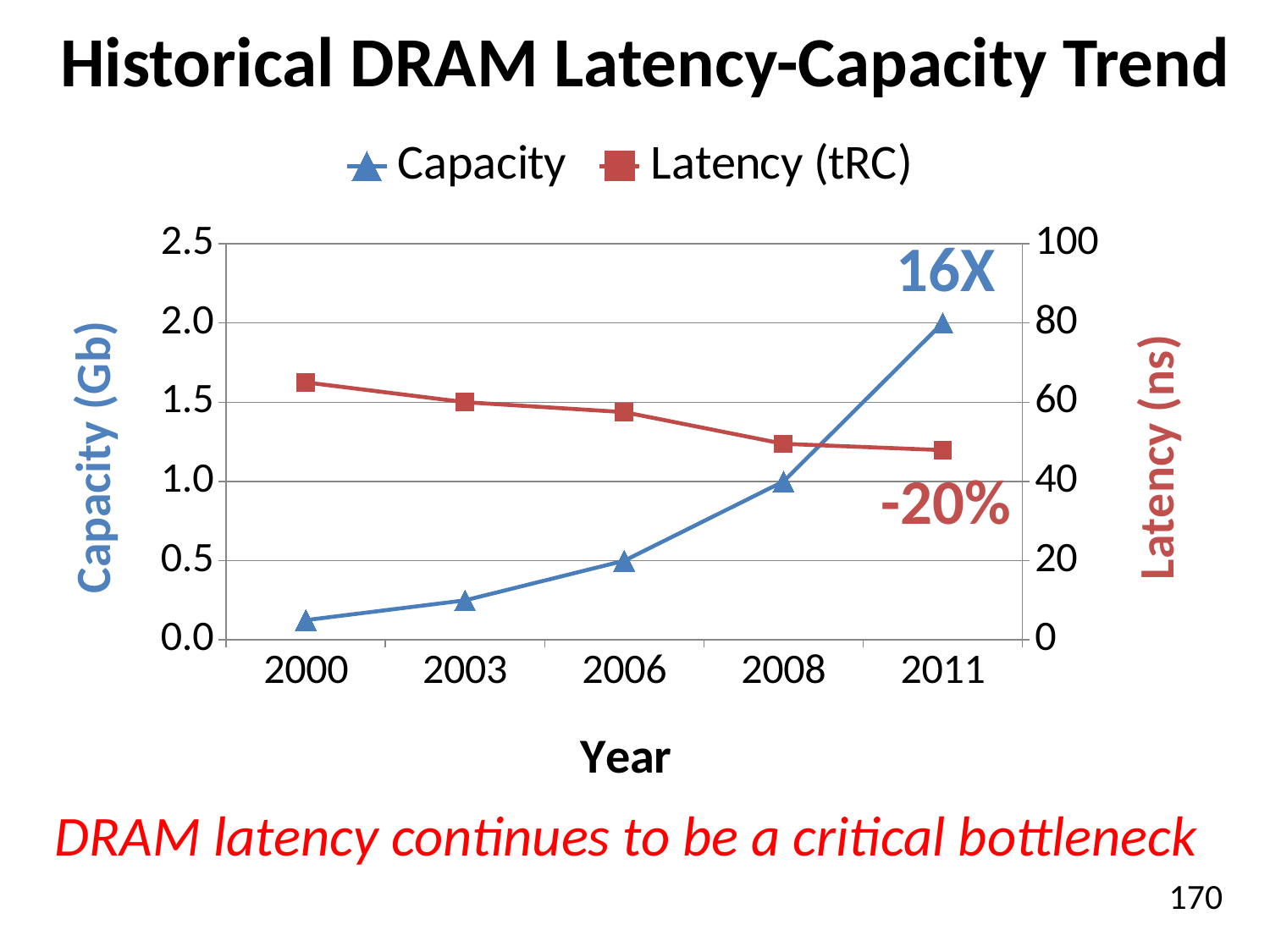
Is the Capacity value for 2006 greater or less than 1.0? less What kind of chart is shown on the slide? Line chart How many series does the legend list? 2 In which year is Latency (tRC) highest? 2000 What is the Capacity value for 2008? 1.0 Is the Latency (tRC) value for 2011 greater or less than 60? less How many years are plotted along the x axis? 5 Does Latency (tRC) rise or fall from 2000 to 2011? Falls Is the Latency (tRC) value for 2000 greater or less than 60? greater Does Capacity rise or fall from 2000 to 2011? Rises What is the Capacity value for 2011? 2.0 What annotation is printed next to the Capacity line near 2011? 16X